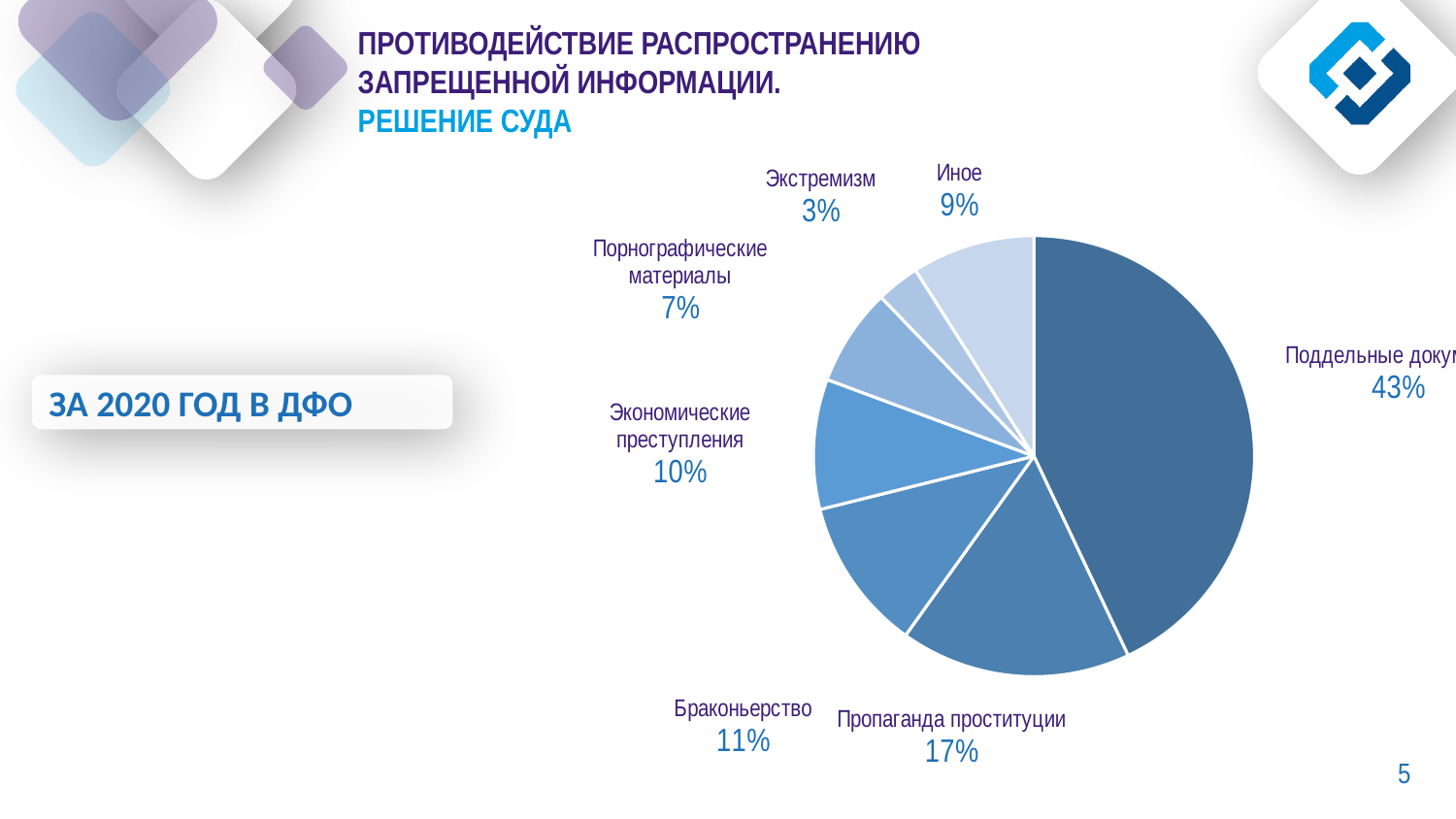
What period and region does the chart cover, according to the label on the left of the slide? ЗА 2020 ГОД В ДФО Which has a larger share, Браконьерство or Экономические преступления? Браконьерство What share of the pie does Иное have? 9% How many slices does the pie chart have? 7 What share of the pie does Браконьерство have? 11% What kind of chart is shown on the slide? pie chart What is the largest percentage shown on the pie chart? 43% What is the difference between the shares of Пропаганда проституции and Браконьерство? 6% What share of the pie does Порнографические материалы have? 7% What share of the pie does Пропаганда проституции have? 17% Which category has the smallest share of the pie? Экстремизм What share of the pie does Экономические преступления have? 10%